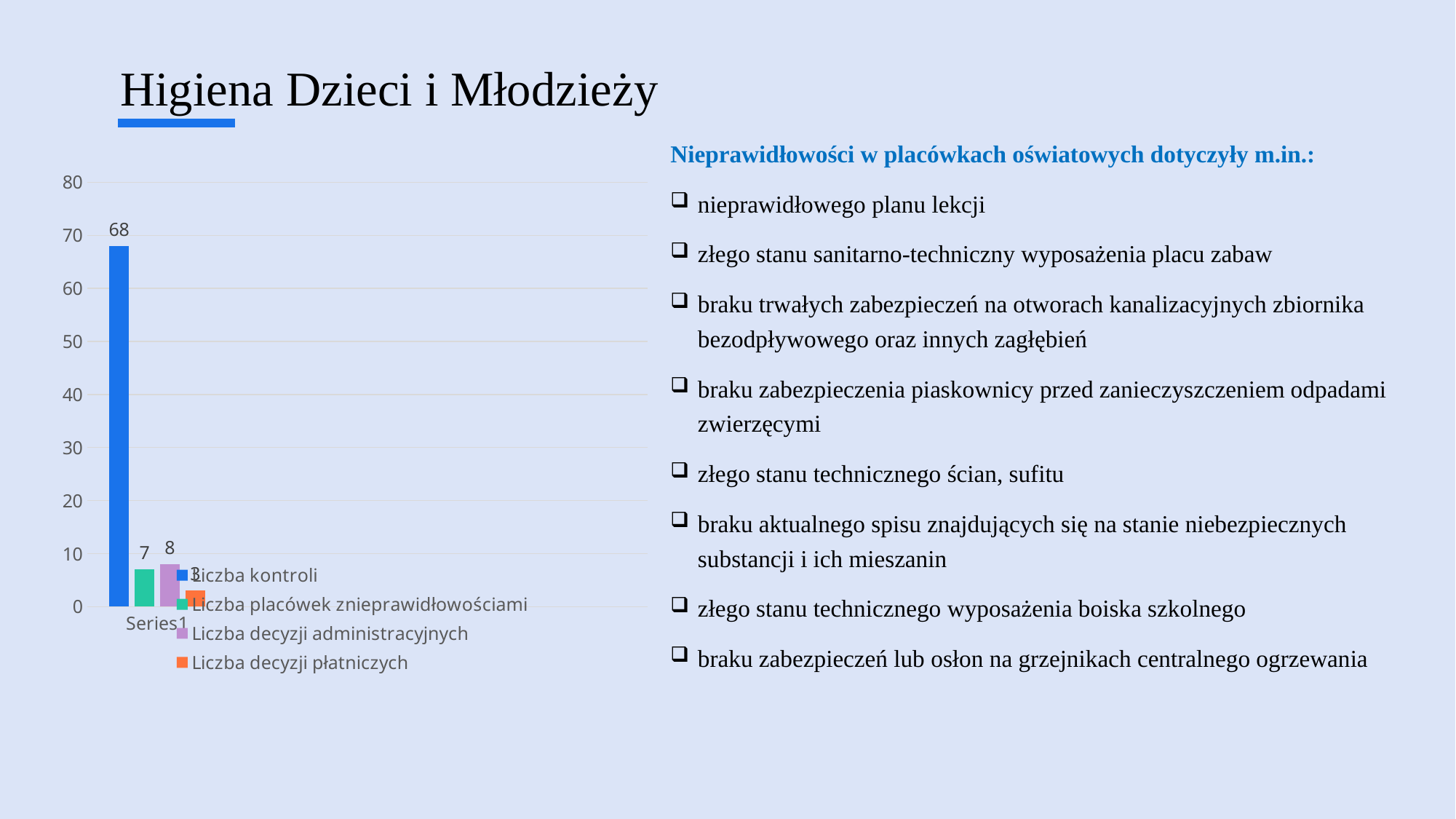
What is the difference between Liczba decyzji administracyjnych and Liczba placówek z nieprawidłowościami? 1 What is the value for Liczba kontroli? 68 Is the value for Liczba decyzji płatniczych greater or less than 10? less What is the value for Liczba decyzji administracyjnych? 8 What is the value for Liczba placówek z nieprawidłowościami? 7 How many series does the chart legend list? 4 Which series has the highest value? Liczba kontroli Which series has the lowest value? Liczba decyzji płatniczych Which is larger, Liczba decyzji administracyjnych or Liczba placówek z nieprawidłowościami? Liczba decyzji administracyjnych What kind of chart is shown on the slide? bar chart What colour is the bar for Liczba kontroli? blue What is the difference between Liczba kontroli and Liczba decyzji administracyjnych? 60